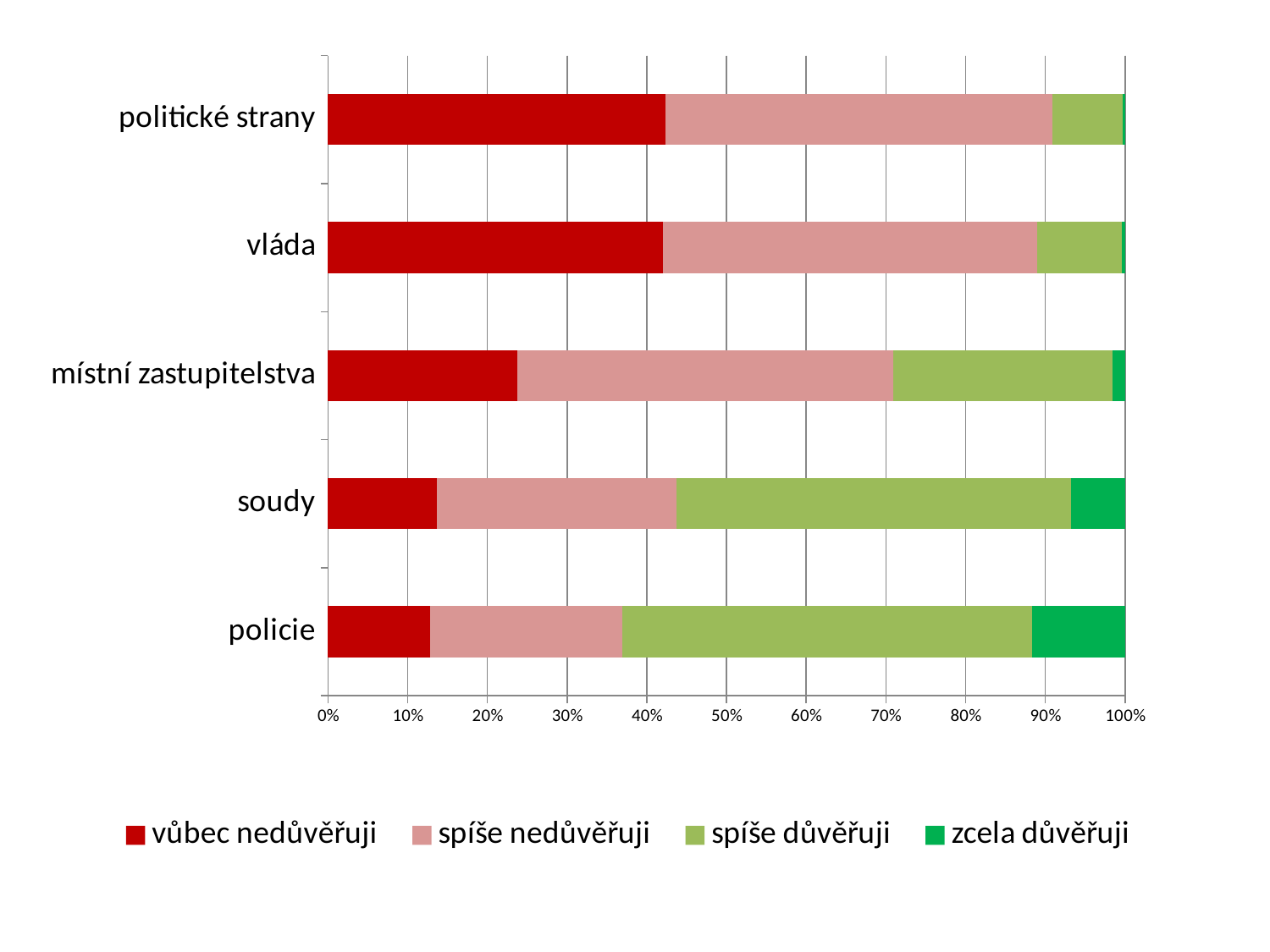
Is the 'vůbec nedůvěřuji' value for 'politické strany' greater or less than 40%? greater How many series does the legend list? 4 Which category is listed at the top of the chart? politické strany Is the 'vůbec nedůvěřuji' value for 'policie' greater or less than 20%? less Is the 'vůbec nedůvěřuji' value for 'soudy' greater or less than 10%? greater Which has the larger 'vůbec nedůvěřuji' value, 'vláda' or 'soudy'? vláda Which category has the largest 'zcela důvěřuji' segment? policie What kind of chart is shown on the slide? bar chart Which category has the smallest 'spíše nedůvěřuji' segment? policie What does each stacked bar total on the horizontal axis? 100% How many categories are shown on the vertical axis of the chart? 5